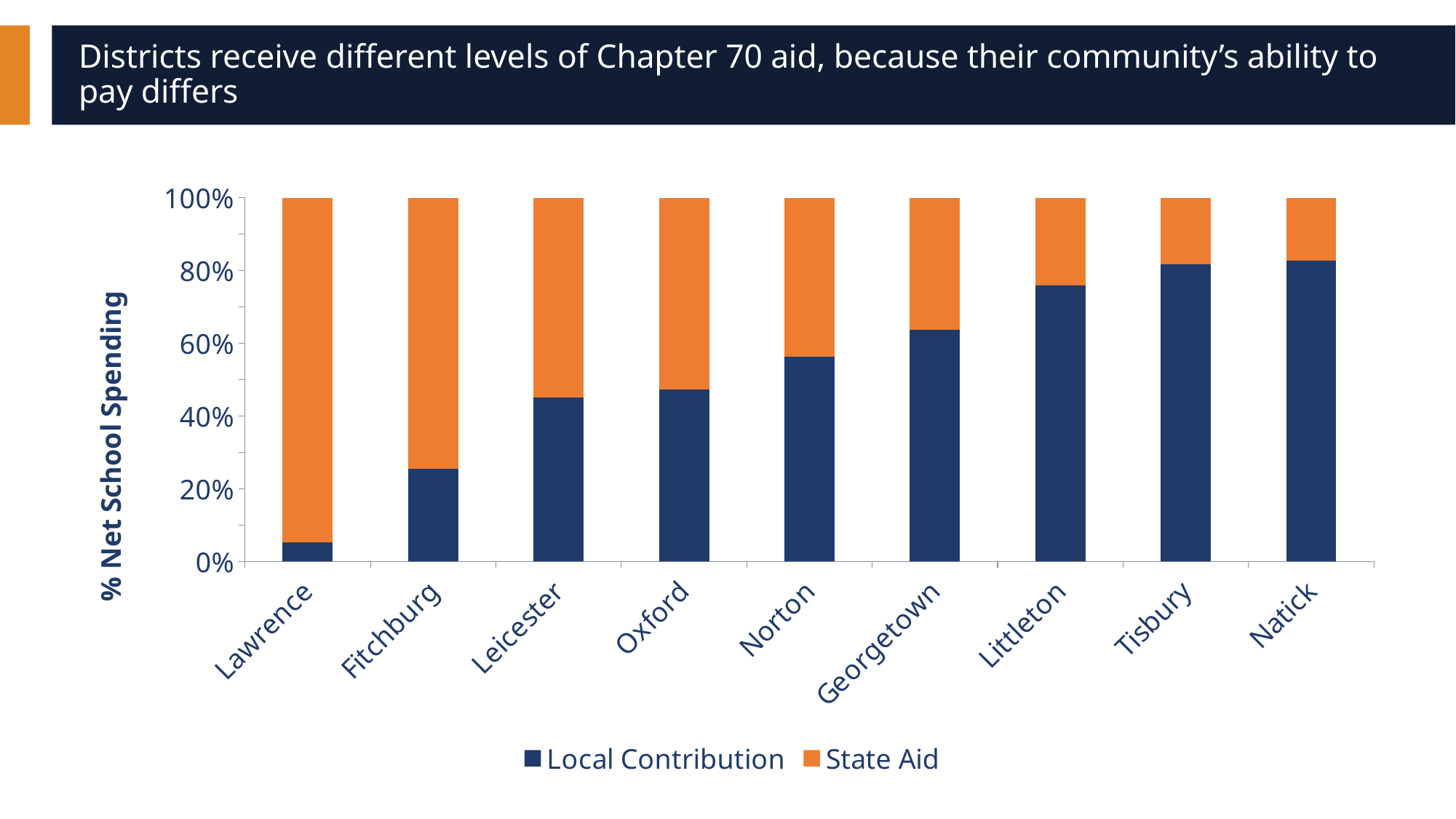
Which district has the lowest Local Contribution share? Lawrence Is the Local Contribution value for Littleton greater or less than 80%? less What kind of chart is shown on the slide? Stacked bar chart Does the Local Contribution share rise or fall moving from Lawrence to Natick along the x axis? Rise How many series does the chart's legend list? 2 How many districts are shown on the x axis of the chart? 9 Is the Local Contribution value for Georgetown greater or less than 60%? greater Which district has the highest State Aid share? Lawrence Which has a larger Local Contribution share, Fitchburg or Leicester? Leicester What is the total of each stacked bar in the chart? 100% Is the Local Contribution value for Lawrence greater or less than 20%? less Which has a larger State Aid share, Norton or Georgetown? Norton